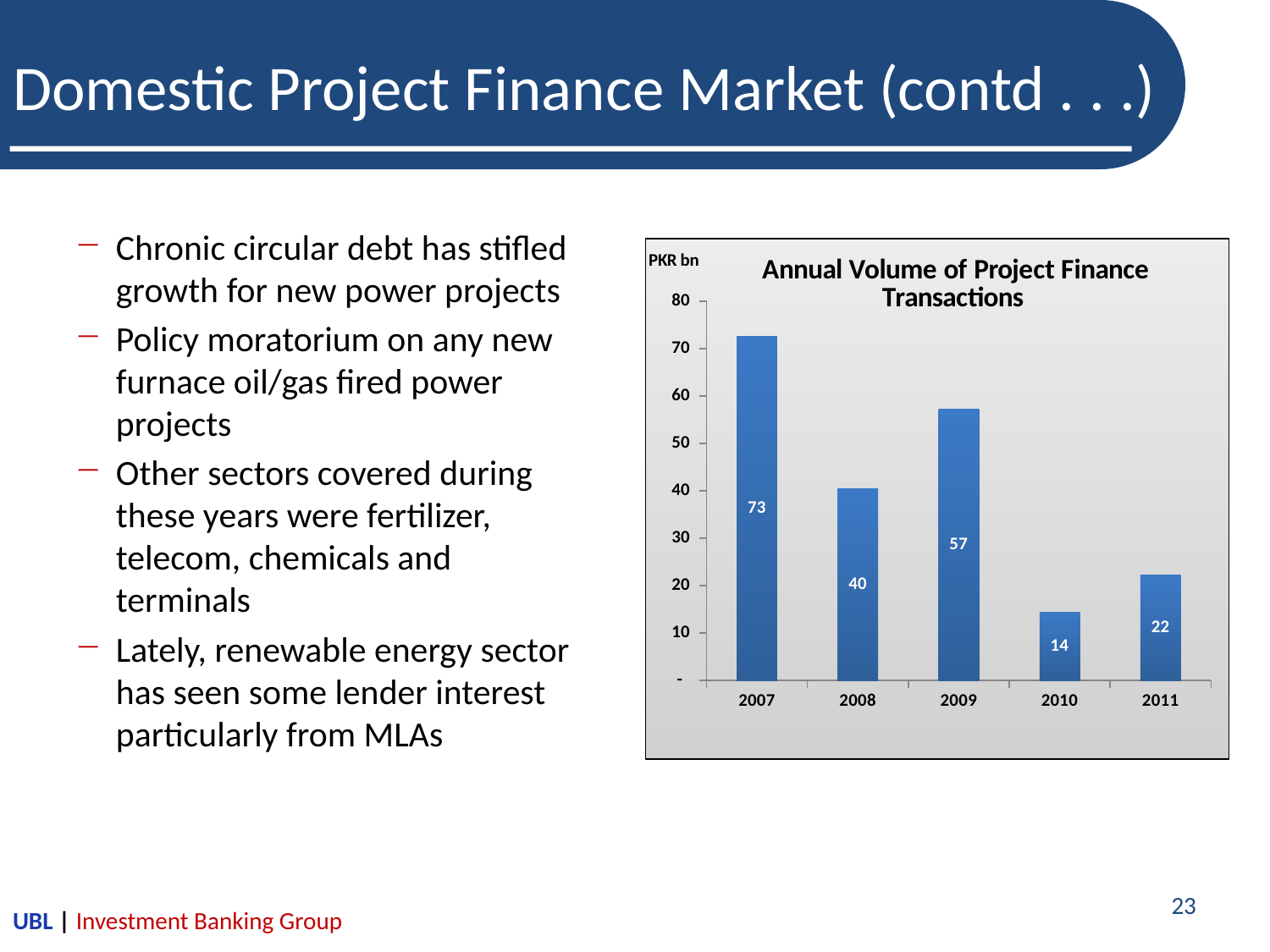
What is the value for 2010 in the Annual Volume of Project Finance Transactions chart? 14 What kind of chart is shown on the slide? bar chart Which year has the highest annual volume of project finance transactions? 2007 What is the difference between the values for 2007 and 2009? 16 How many years are shown on the x axis of the chart? 5 Which year has the lowest annual volume of project finance transactions? 2010 What is the difference between the values for 2008 and 2010? 26 What unit is indicated in the top-left corner of the chart? PKR bn Is the value for 2011 greater or less than 30? less What is the value for 2011 in the Annual Volume of Project Finance Transactions chart? 22 What is the value for 2007 in the Annual Volume of Project Finance Transactions chart? 73 Which is larger, the value for 2008 or the value for 2009? 2009